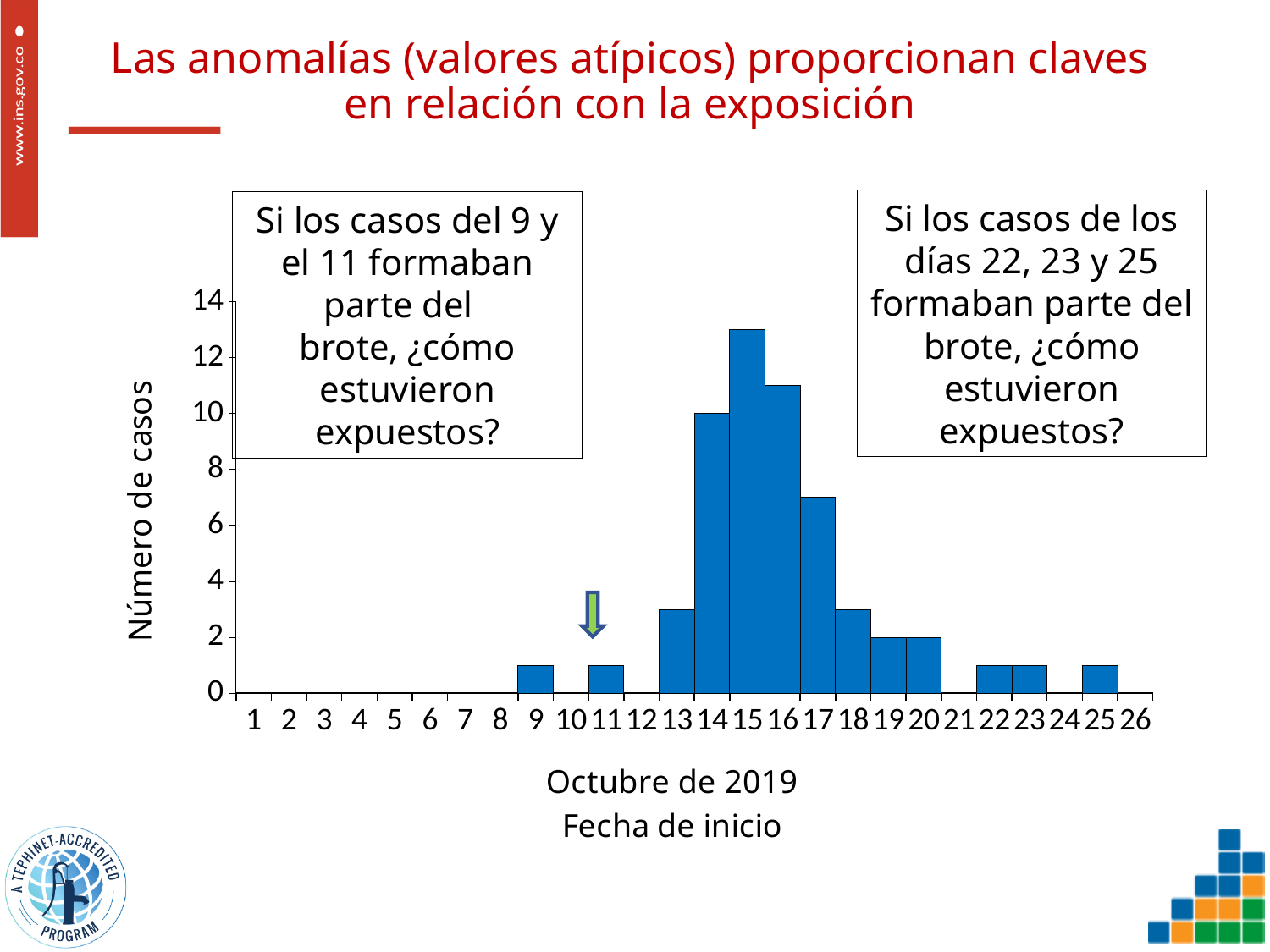
What kind of chart is shown on the slide? bar chart Which day has more cases, day 15 or day 17? 15 Is the number of cases for day 13 greater or less than 2? greater Is the number of cases for day 15 greater or less than 12? greater Is the number of cases for day 9 greater or less than 2? less Do the number of cases rise or fall from day 15 to day 20? fall How many days are labelled on the x axis? 26 Which day of October has the highest number of cases? 15 How many cases are shown for day 14 of October? 10 How many cases are shown for day 20 of October? 2 How many cases are shown for day 19 of October? 2